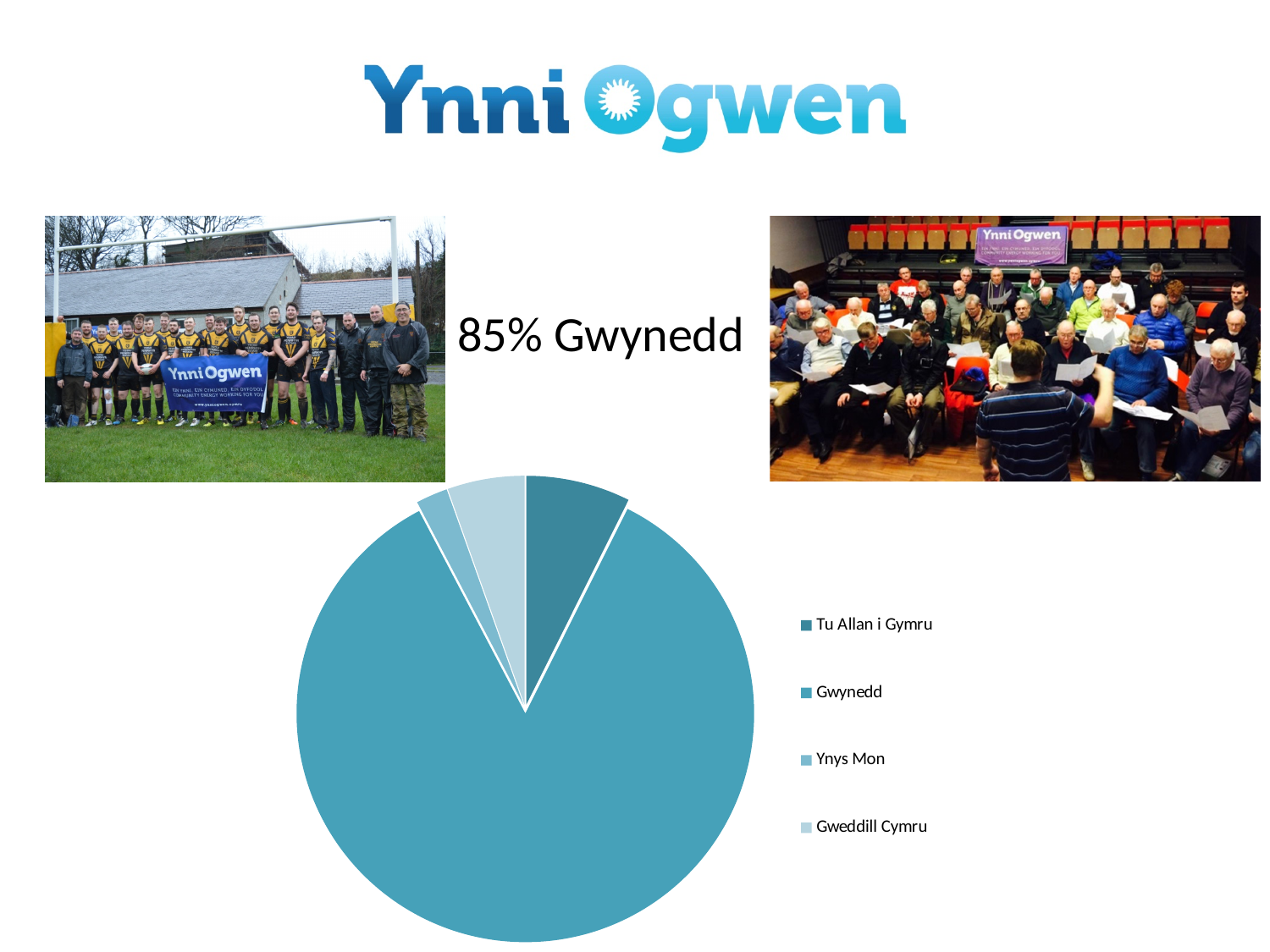
Which slice is larger in the pie chart, Tu Allan i Gymru or Ynys Mon? Tu Allan i Gymru Which legend entry is listed last in the pie chart's legend? Gweddill Cymru Which category has the largest slice of the pie chart? Gwynedd Which legend entry is listed first in the pie chart's legend? Tu Allan i Gymru Which slice is larger in the pie chart, Gwynedd or Tu Allan i Gymru? Gwynedd How many categories does the pie chart's legend list? 4 Which slice is larger in the pie chart, Gweddill Cymru or Ynys Mon? Gweddill Cymru According to the slide, what share of the pie does Gwynedd represent? 85% Which category has the smallest slice of the pie chart? Ynys Mon What kind of chart is shown on the slide? pie chart